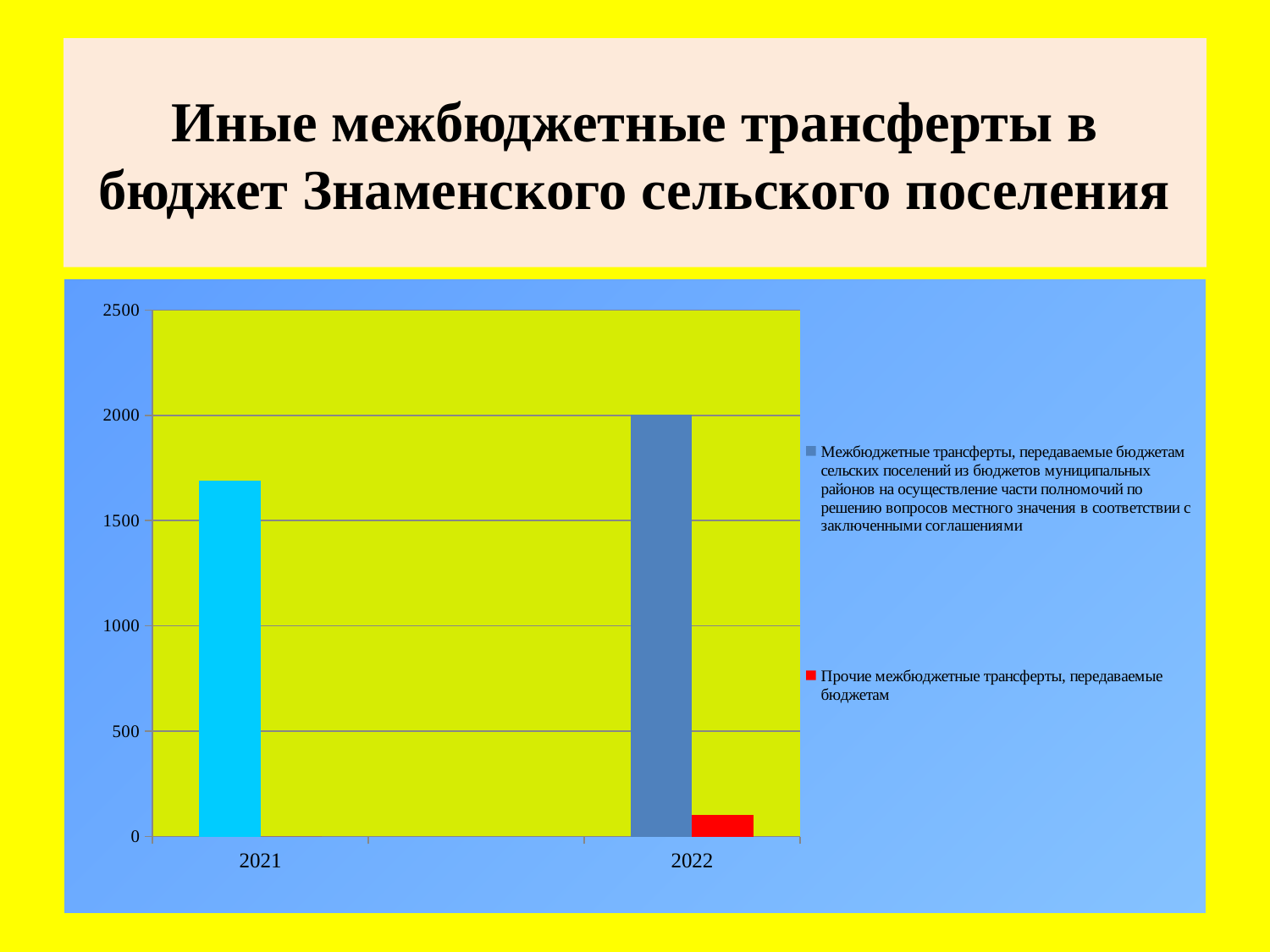
What kind of chart is shown on the slide? bar chart Which year has the tallest bar in the chart? 2022 Is the value of the tallest bar for 2022 greater or less than 1500? greater Is the value of the bar for 2021 greater or less than 2000? less Is the value of the red bar for 2022 greater or less than 500? less How many series does the chart's legend list? 2 Does the height of the tallest bar rise or fall from 2021 to 2022? rise How many years (categories) are shown on the x axis of the chart? 2 What colour is used in the legend for the series "Прочие межбюджетные трансферты, передаваемые бюджетам"? red What is the title of the slide containing the chart? Иные межбюджетные трансферты в бюджет Знаменского сельского поселения Which is larger: the bar for 2021 or the tallest bar for 2022? the tallest bar for 2022